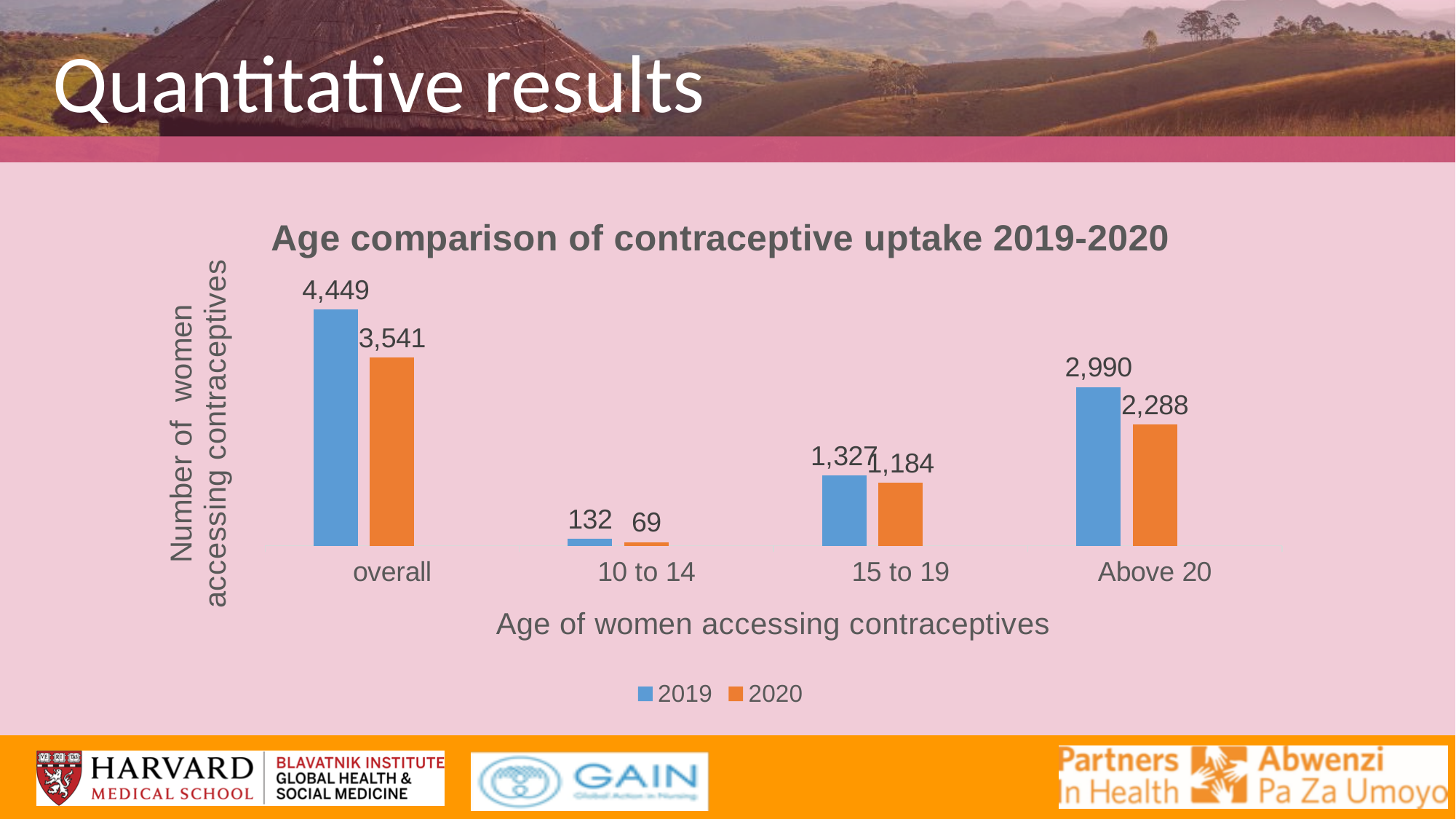
What is the 2019 value for the 15 to 19 age group? 1,327 What is the 2019 value for the overall category? 4,449 How many series does the legend list? 2 Which is larger for the 15 to 19 age group, the 2019 value or the 2020 value? 2019 What type of chart is shown on the slide? Bar chart What is the difference between the 2019 and 2020 values for the overall category? 908 What is the 2020 value for the 10 to 14 age group? 69 How many categories are shown on the x axis? 4 What is the 2020 value for the Above 20 age group? 2,288 Which age group (excluding overall) has the highest 2020 value? Above 20 What is the difference between the 2019 and 2020 values for the Above 20 age group? 702 Which age group (excluding overall) has the lowest 2019 value? 10 to 14